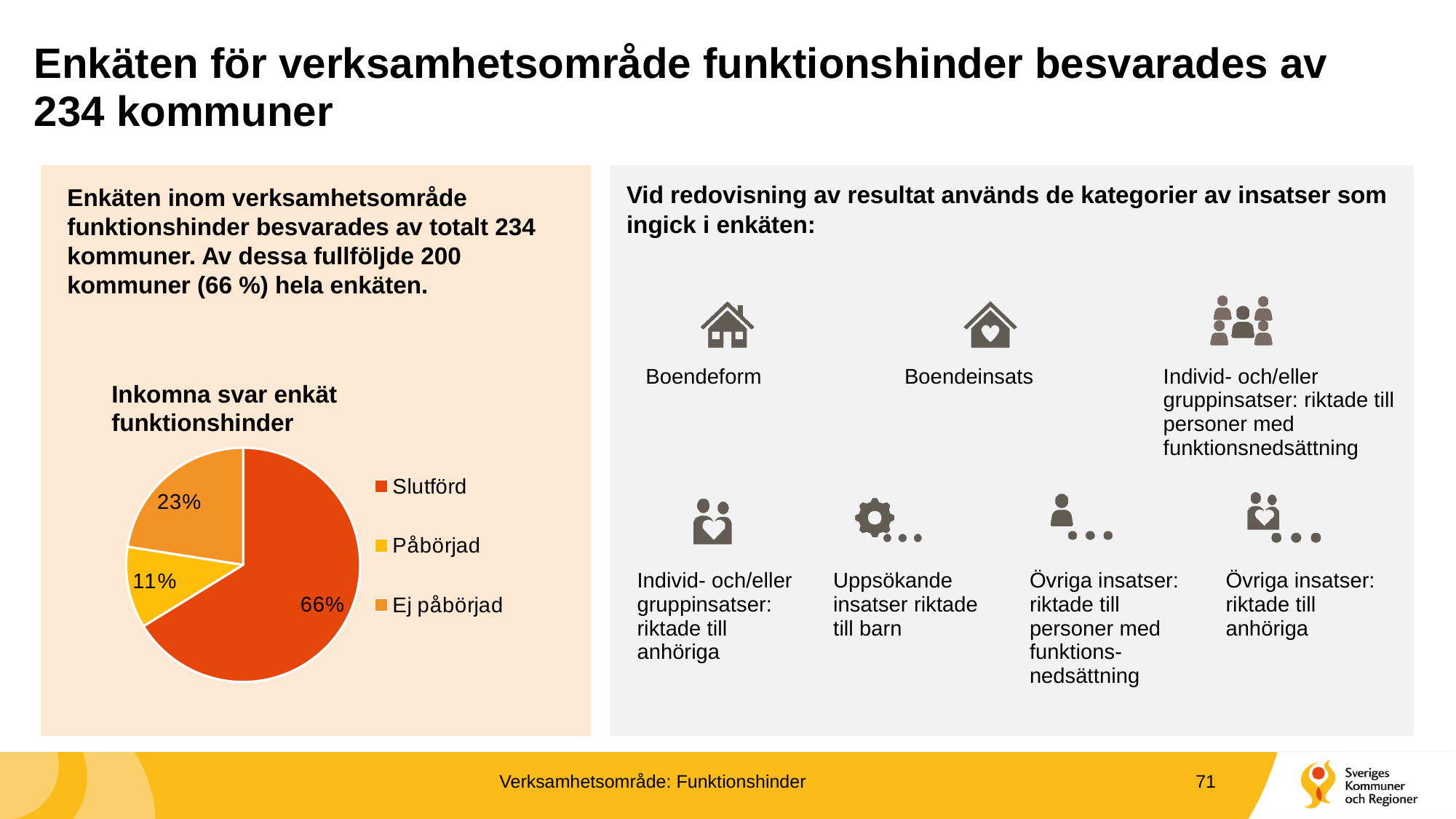
Which is larger, the share for Ej påbörjad or the share for Påbörjad? Ej påbörjad What share of the pie does Slutförd represent? 66% How many entries does the legend list? 3 What is the title of the chart? Inkomna svar enkät funktionshinder How many slices does the pie chart have? 3 What share of the pie does Påbörjad represent? 11% What share of the pie does Ej påbörjad represent? 23% What colour is the Påbörjad slice in the pie chart? yellow What is the difference in percentage points between Slutförd and Ej påbörjad? 43 Which category has the largest slice of the pie? Slutförd Which category has the smallest slice of the pie? Påbörjad What type of chart is shown on the slide? pie chart